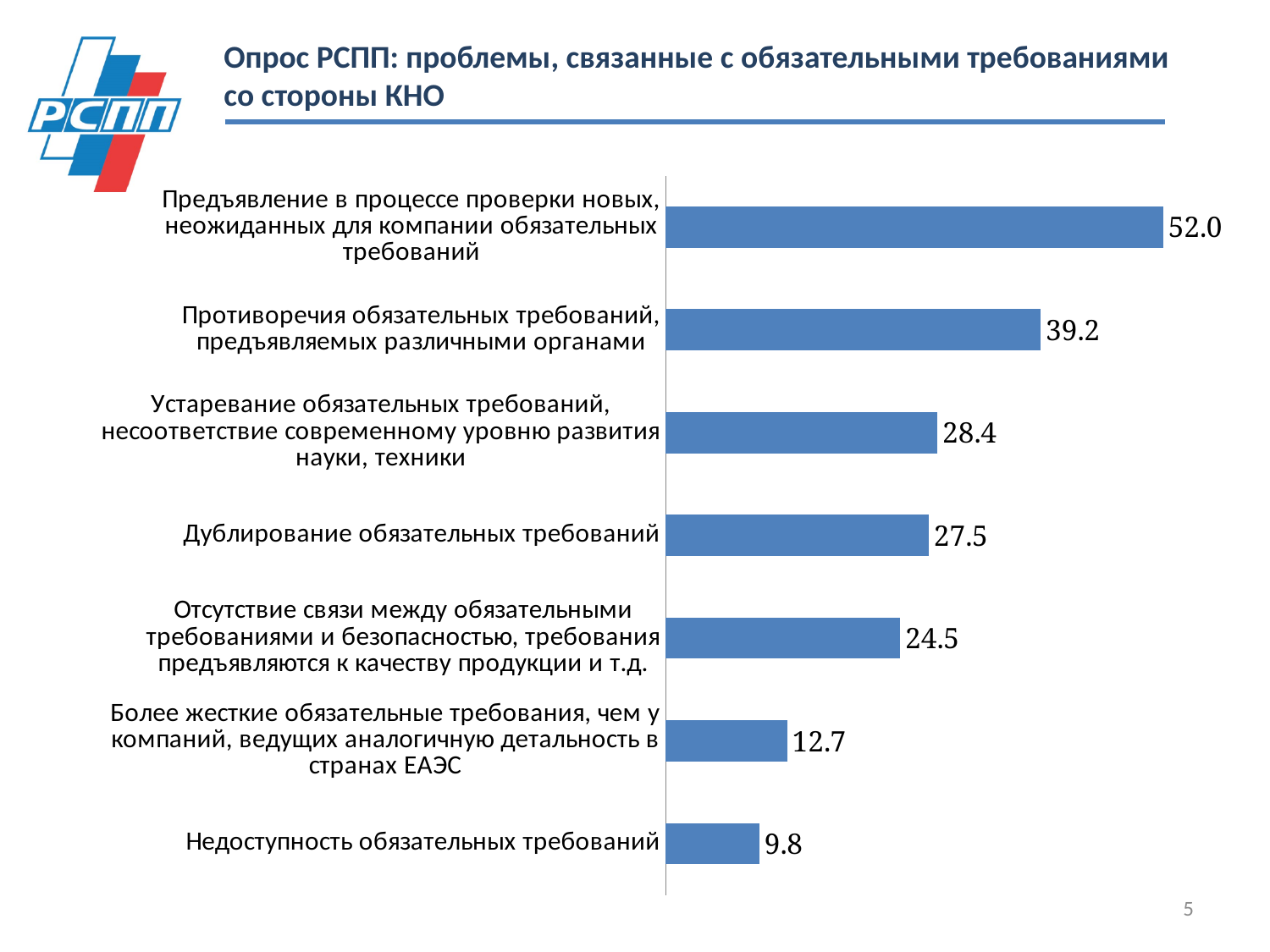
What value is shown for "Дублирование обязательных требований"? 27.5 What is the difference between the values for "Предъявление в процессе проверки новых, неожиданных для компании обязательных требований" and "Противоречия обязательных требований, предъявляемых различными органами"? 12.8 Which is larger: the value for "Устаревание обязательных требований, несоответствие современному уровню развития науки, техники" or the value for "Отсутствие связи между обязательными требованиями и безопасностью, требования предъявляются к качеству продукции и т.д."? Устаревание обязательных требований, несоответствие современному уровню развития науки, техники What value is shown for "Более жесткие обязательные требования, чем у компаний, ведущих аналогичную детальность в странах ЕАЭС"? 12.7 What is the title of the slide containing the chart? Опрос РСПП: проблемы, связанные с обязательными требованиями со стороны КНО What value is shown for "Недоступность обязательных требований"? 9.8 How many categories are shown in the chart? 7 What is the difference between the values for "Дублирование обязательных требований" and "Недоступность обязательных требований"? 17.7 Which category has the highest value? Предъявление в процессе проверки новых, неожиданных для компании обязательных требований What kind of chart is shown on the slide? Bar chart What value is shown for "Противоречия обязательных требований, предъявляемых различными органами"? 39.2 Which category has the lowest value? Недоступность обязательных требований